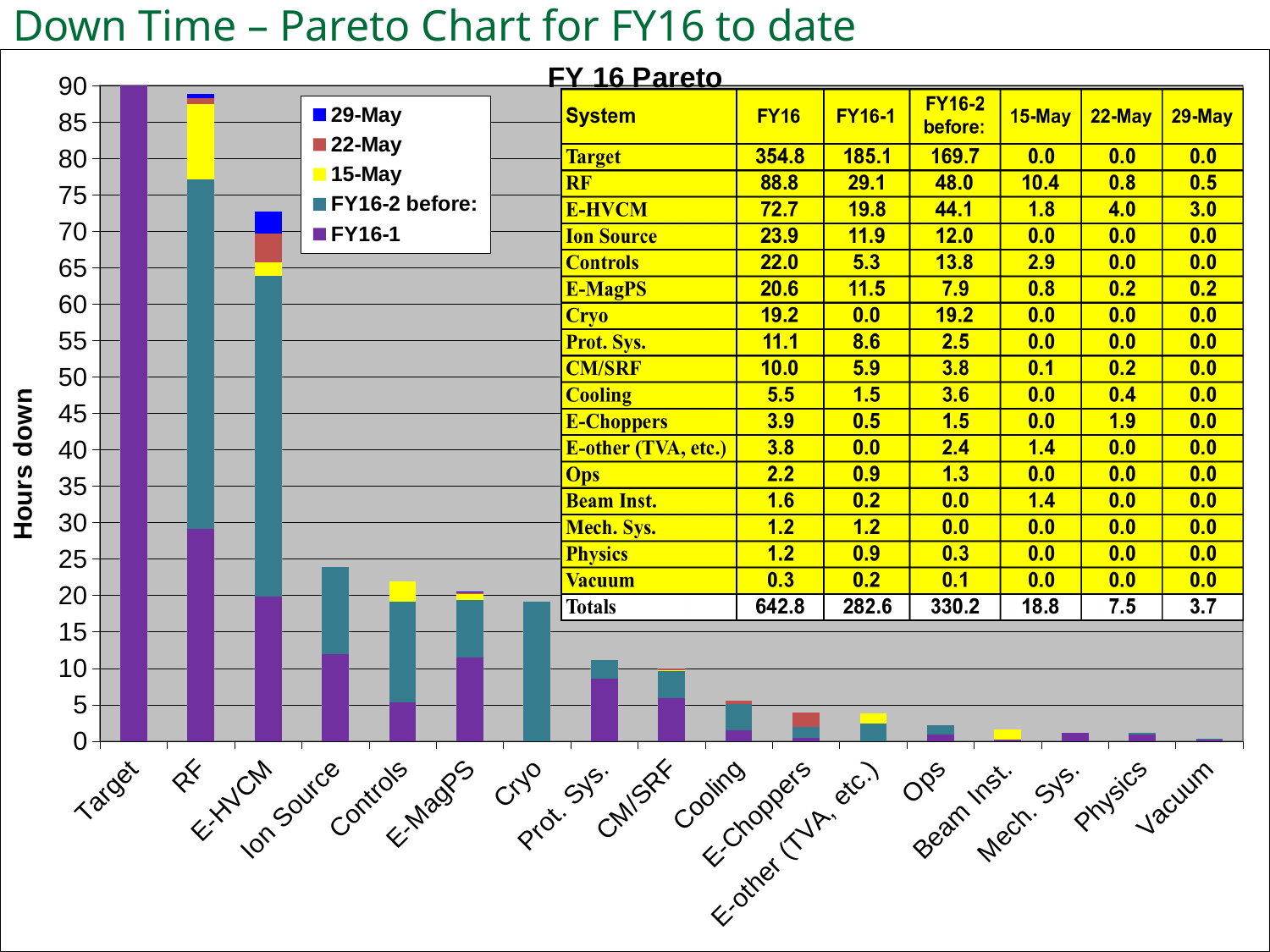
What is the difference between the FY16 totals for RF and E-HVCM? 16.1 What kind of chart is shown on the slide? Stacked bar chart Which system has the lowest total hours down in the chart? Vacuum Do the bar totals rise or fall moving from left to right along the x axis? Fall According to the table, what is the FY16-2 before value for Cryo? 19.2 How many systems (categories) are plotted along the x axis of the chart? 17 What is the total FY16 hours down for the Ion Source bar? 23.9 Which system has the highest total hours down in the chart? Target Is the total value for E-HVCM greater or less than 70? greater How many series does the chart legend list? 5 Which has more total hours down, Cryo or Prot. Sys.? Cryo According to the table, what is the FY16-1 value for RF? 29.1